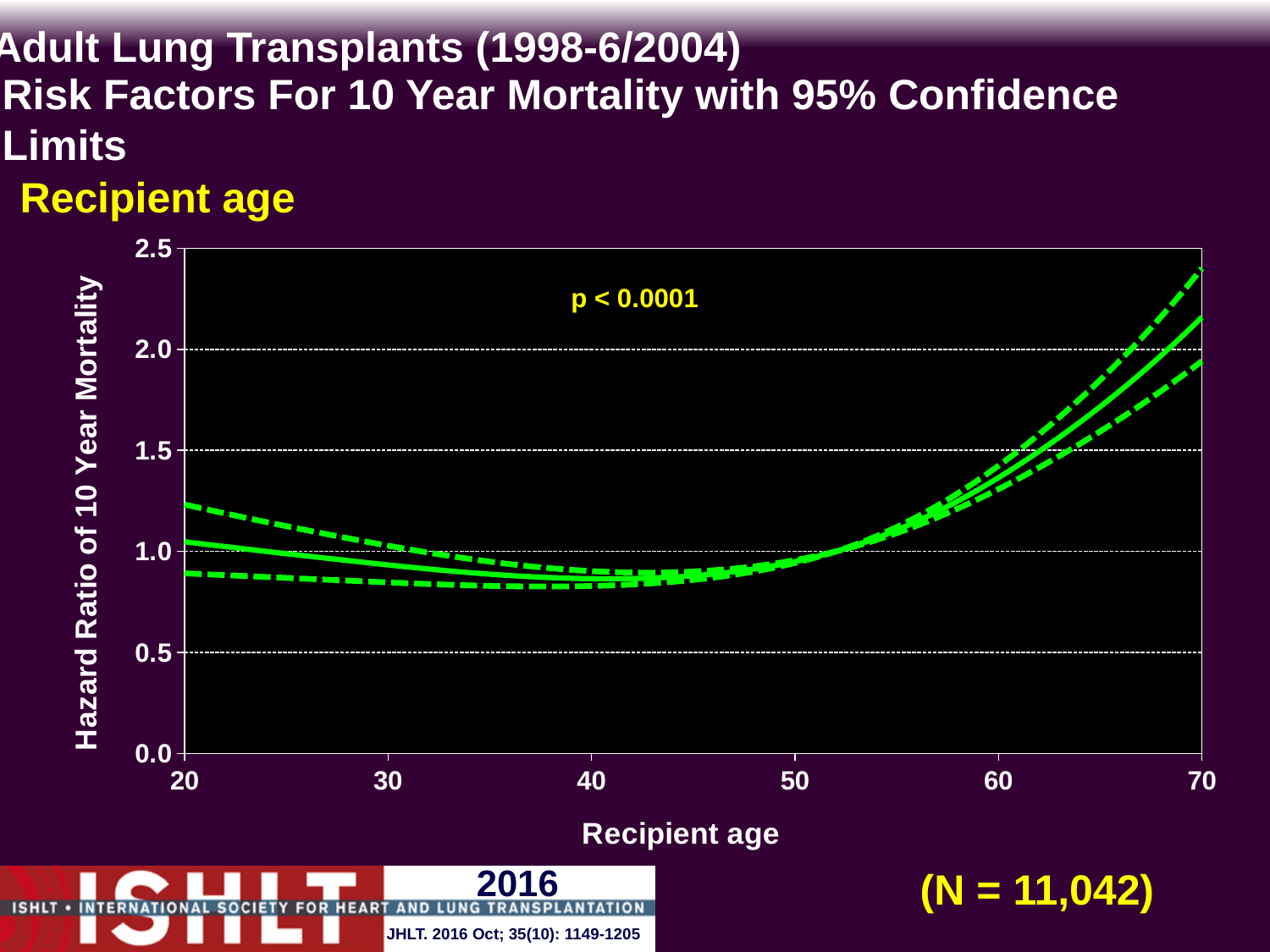
Is the hazard ratio on the solid line at recipient age 40 greater or less than 1.0? less What is the label of the y axis? Hazard Ratio of 10 Year Mortality What kind of chart is shown on the slide? line chart Is the hazard ratio on the solid line at recipient age 70 greater or less than 2.0? greater What p-value is printed on the chart? p < 0.0001 Does the solid hazard ratio line rise or fall between recipient age 20 and 40? fall How many lines are plotted on the chart? 3 What is the label of the x axis? Recipient age What sample size (N) is shown on the slide? N = 11,042 Does the solid hazard ratio line rise or fall between recipient age 50 and 70? rise Is the upper dashed confidence limit at recipient age 20 greater or less than 1.0? greater